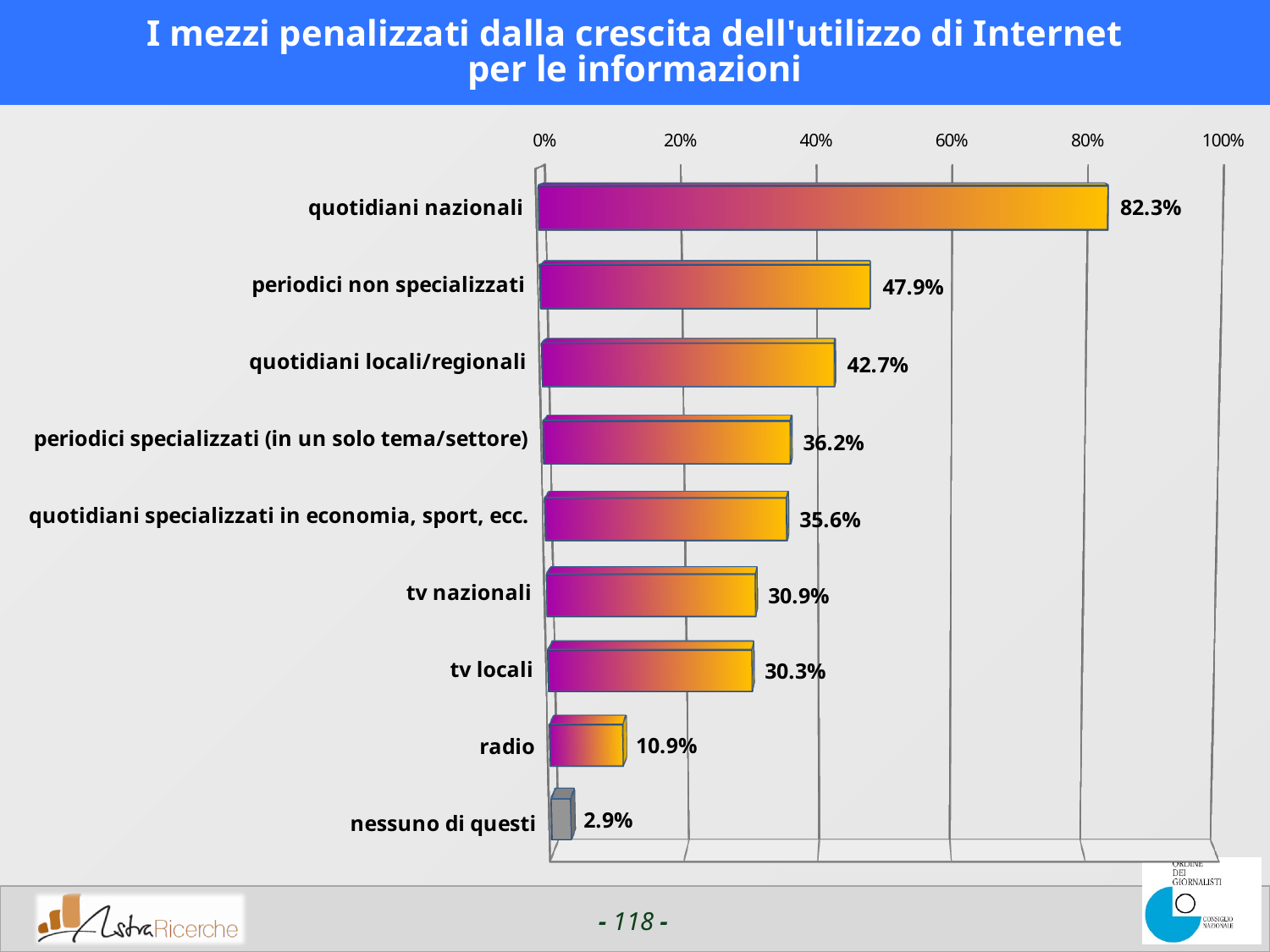
What is the value for radio? 10.9% What kind of chart is shown on the slide? bar chart Which is larger, the value for quotidiani locali/regionali or the value for periodici specializzati (in un solo tema/settore)? quotidiani locali/regionali What is the difference between the values for quotidiani nazionali and periodici non specializzati? 34.4% What is the difference between the values for tv nazionali and tv locali? 0.6% What is the title of the slide? I mezzi penalizzati dalla crescita dell'utilizzo di Internet per le informazioni How many categories are shown in the chart? 9 Is the value for periodici non specializzati greater or less than 40%? greater What is the value for quotidiani nazionali? 82.3% Which category has the highest value? quotidiani nazionali What is the value for tv locali? 30.3% Which category has the lowest value? nessuno di questi